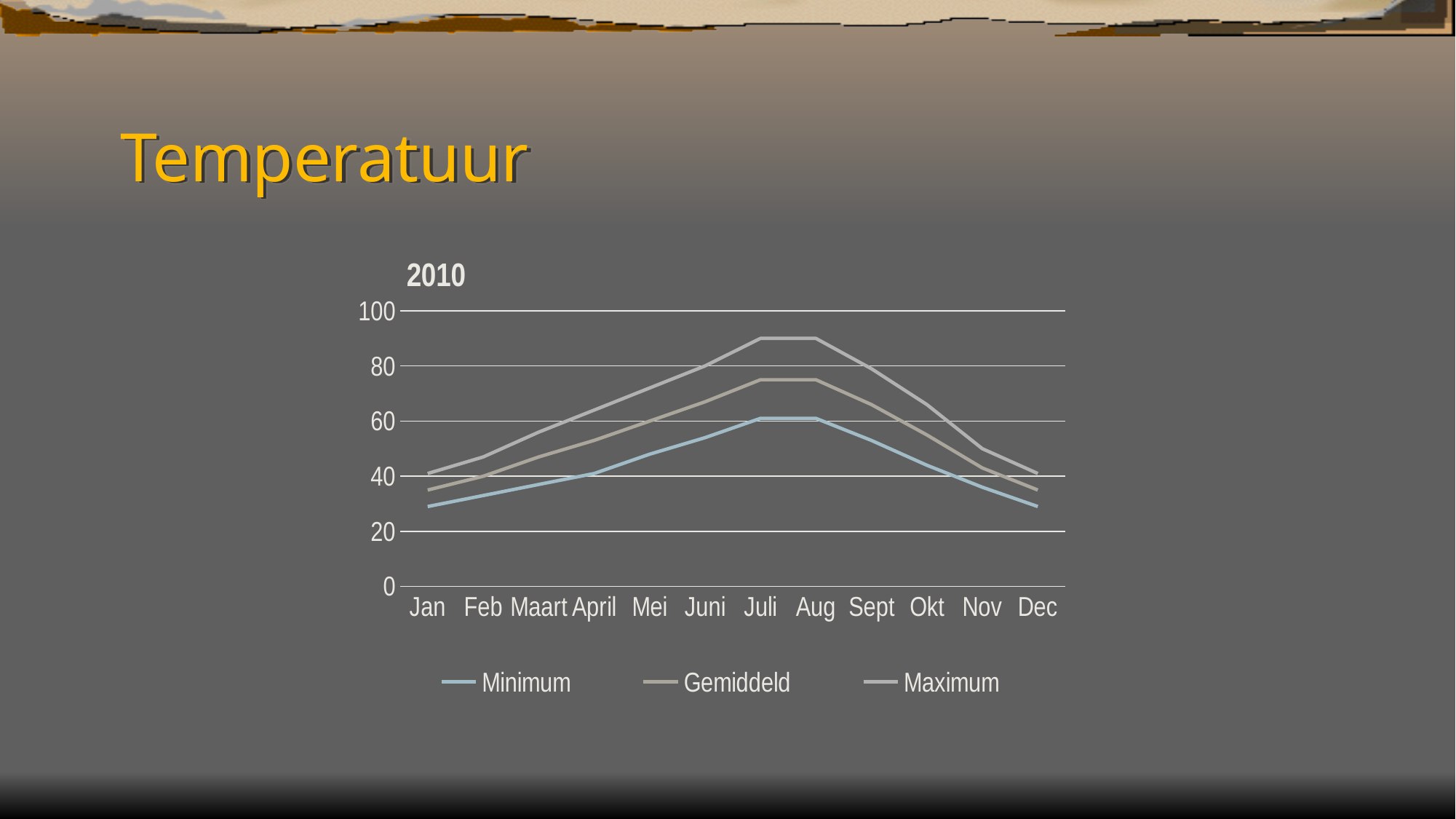
Which series are listed in the chart's legend? Minimum, Gemiddeld, Maximum Is the Maximum value for Nov greater or less than 40? greater Is the Gemiddeld value for Juli greater or less than 60? greater Does the Minimum series rise or fall from Jan to Juli? rise Is the Minimum value for Jan greater or less than 40? less How many months are plotted along the x axis of the chart? 12 What is the title of the chart? 2010 Which series has the higher value in Juli, Minimum or Maximum? Maximum How many series does the chart's legend list? 3 What kind of chart is shown on the slide? line chart